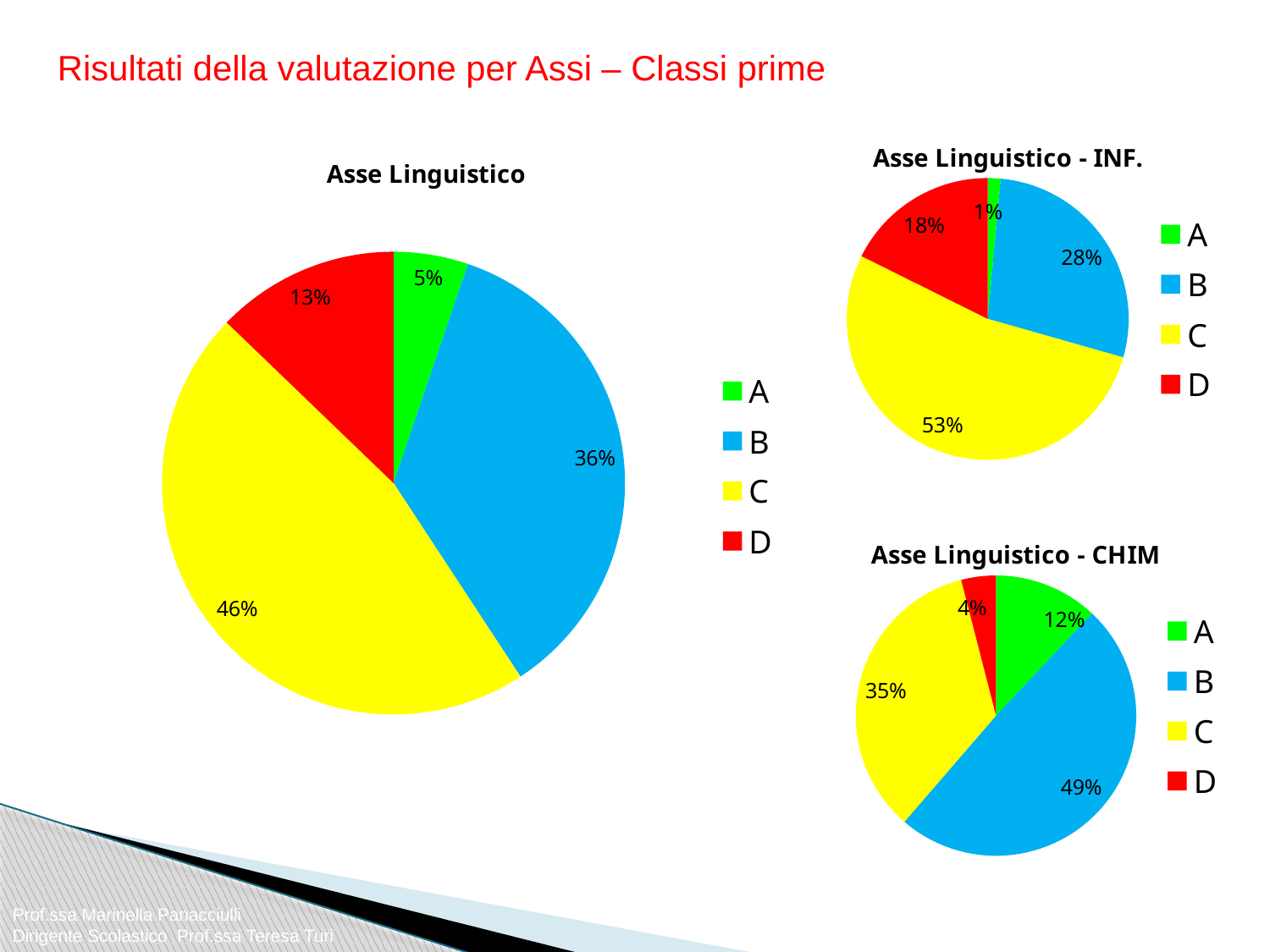
In the 'Asse Linguistico - INF.' chart, what share does category B have? 28% In the 'Asse Linguistico - INF.' chart, which category has the largest slice? C In the 'Asse Linguistico - CHIM' chart, what is the difference between the shares of C and A? 23% How many categories does the legend of the 'Asse Linguistico' chart list? 4 In the 'Asse Linguistico - CHIM' chart, which is larger, the share of A or the share of D? A What kind of chart is 'Asse Linguistico - CHIM'? Pie chart In the 'Asse Linguistico' chart, what share does category C have? 46% In the 'Asse Linguistico' chart, what is the difference between the shares of B and D? 23% In the 'Asse Linguistico - INF.' chart, what share does category A have? 1% In the 'Asse Linguistico - INF.' chart, what colour is the slice for category D? Red In the 'Asse Linguistico' chart, which category has the smallest slice? A In the 'Asse Linguistico - CHIM' chart, what share does category B have? 49%